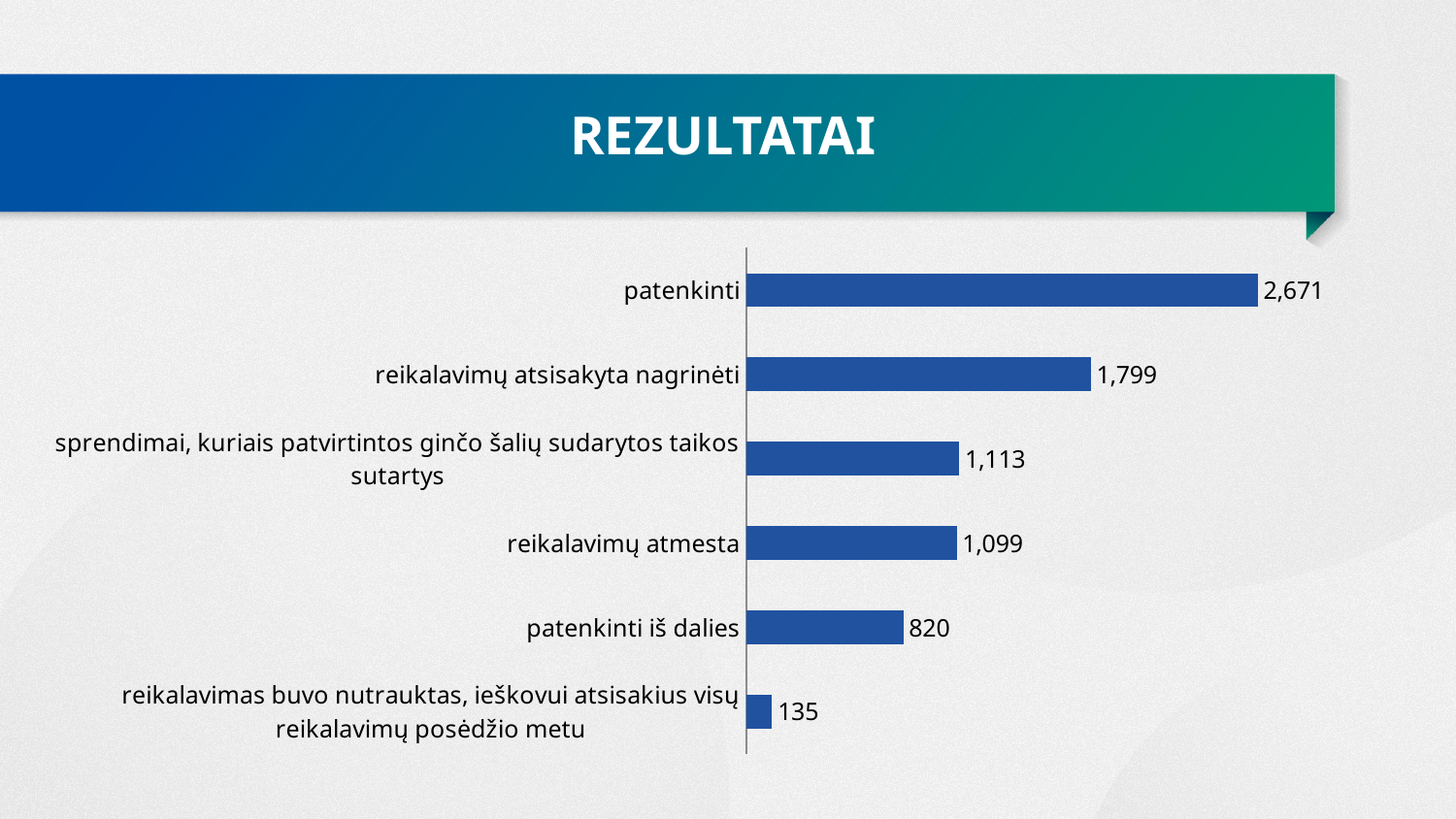
What kind of chart is shown on the slide? bar chart What is the value for "reikalavimas buvo nutrauktas, ieškovui atsisakius visų reikalavimų posėdžio metu"? 135 Which category has the highest value? patenkinti What is the value for "patenkinti"? 2,671 What is the difference between the values for "sprendimai, kuriais patvirtintos ginčo šalių sudarytos taikos sutartys" and "reikalavimų atmesta"? 14 Which is larger: the value for "reikalavimų atsisakyta nagrinėti" or the value for "patenkinti iš dalies"? reikalavimų atsisakyta nagrinėti What is the difference between the values for "patenkinti" and "reikalavimų atsisakyta nagrinėti"? 872 What is the title of the slide? REZULTATAI What is the value for "reikalavimų atsisakyta nagrinėti"? 1,799 How many categories are shown in the chart? 6 What is the value for "patenkinti iš dalies"? 820 Which category has the lowest value? reikalavimas buvo nutrauktas, ieškovui atsisakius visų reikalavimų posėdžio metu